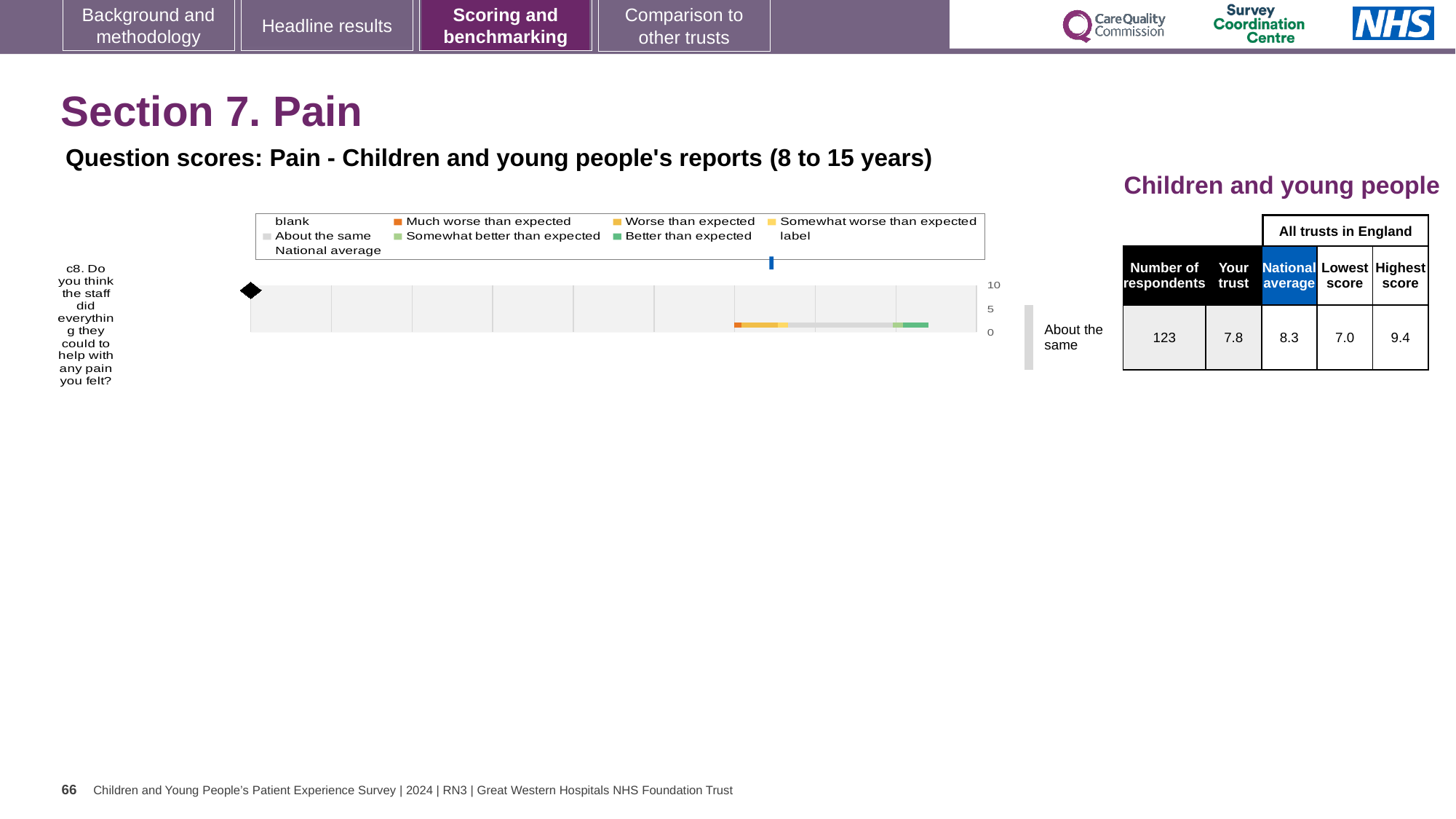
Is the trust's score for question c8 greater or less than 5? greater What is the 'Your trust' score for question c8 about helping with pain? 7.8 Which benchmark category is the trust's result for question c8 placed in? About the same What is the difference between the highest and lowest scores for question c8? 2.4 What is the highest score among all trusts in England for question c8? 9.4 What kind of chart is used to show the question score for c8? bar chart By how much does the national average exceed the trust's score for question c8? 0.5 What is the lowest score among all trusts in England for question c8? 7.0 How many respondents answered question c8? 123 What is the national average score for question c8? 8.3 How many questions are plotted on the chart? 1 Which is higher for question c8, the trust's score or the national average? National average